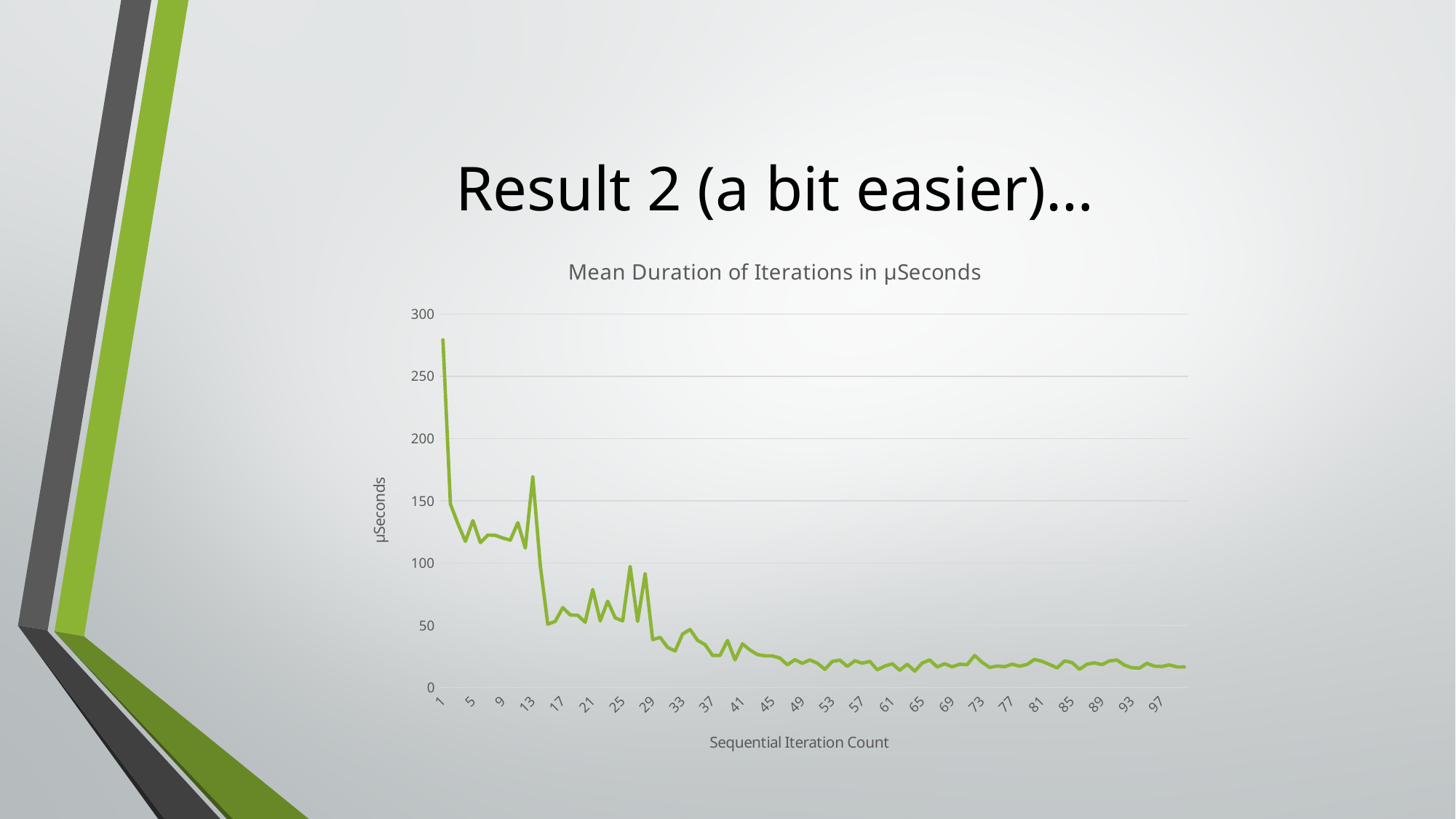
Is the value at iteration 1 greater or less than 250? greater Do the values generally rise or fall as the iteration count increases along the x axis? fall Which has the larger value, iteration 13 or iteration 61? iteration 13 What kind of chart is shown on the slide? line chart Which has the larger value, iteration 1 or iteration 13? iteration 1 What is the highest value shown on the y axis? 300 What is the title of the chart? Mean Duration of Iterations in µSeconds Is the value at iteration 97 greater or less than 50? less What is the label of the x axis? Sequential Iteration Count Is the value at iteration 13 greater or less than 150? greater At which iteration count is the mean duration highest? 1